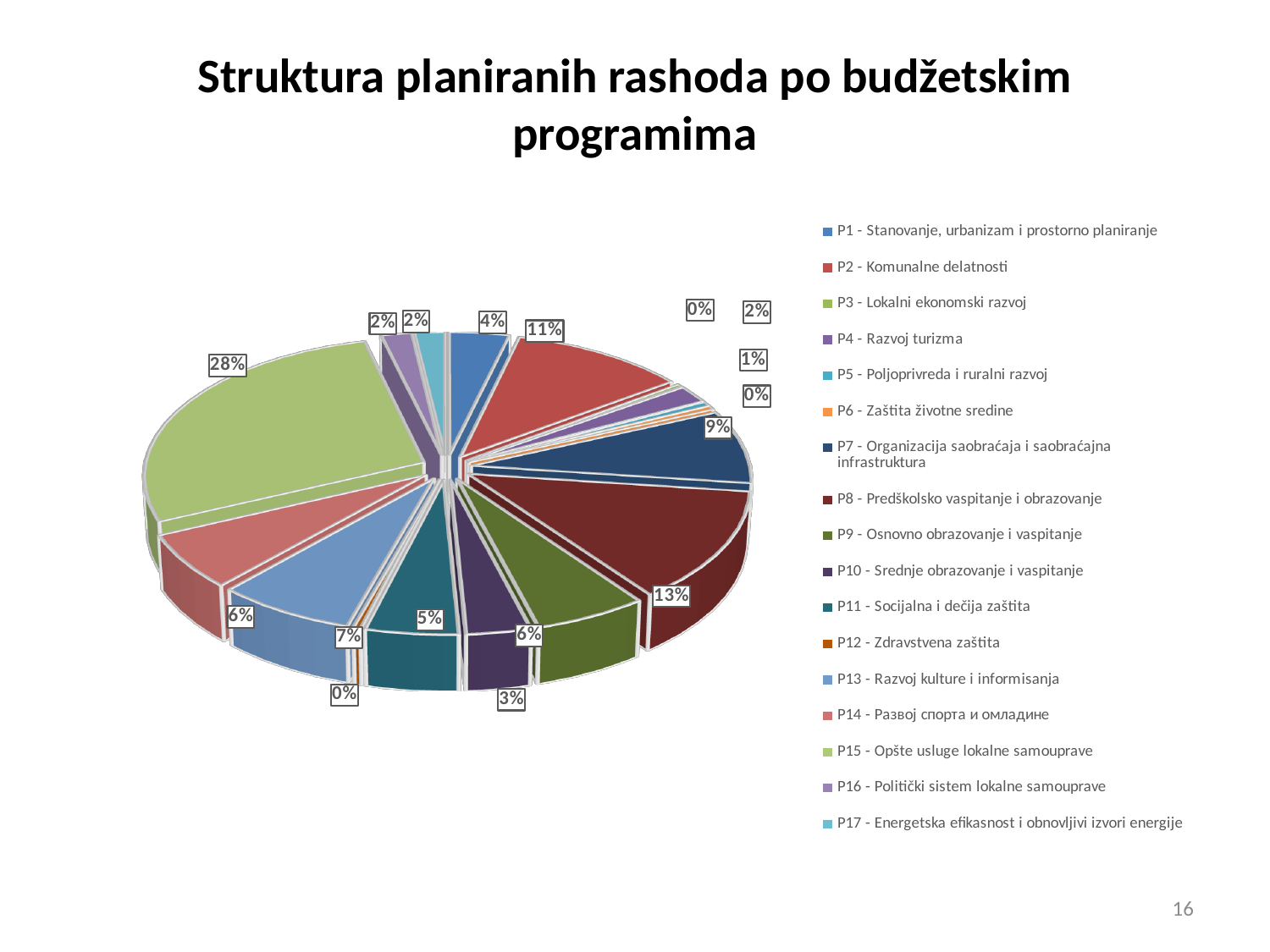
What share is shown for P2 - Komunalne delatnosti? 11% What share is shown for P7 - Organizacija saobraćaja i saobraćajna infrastruktura? 9% Which has the larger share, P2 - Komunalne delatnosti or P7 - Organizacija saobraćaja i saobraćajna infrastruktura? P2 - Komunalne delatnosti By how many percentage points does the share of P15 - Opšte usluge lokalne samouprave exceed that of P8 - Predškolsko vaspitanje i obrazovanje? 15 percentage points What share is shown for P13 - Razvoj kulture i informisanja? 7% How many categories does the legend list? 17 What kind of chart is shown on the slide? pie chart What is the title of the chart? Struktura planiranih rashoda po budžetskim programima Which program has the largest share of planned expenditures? P15 - Opšte usluge lokalne samouprave